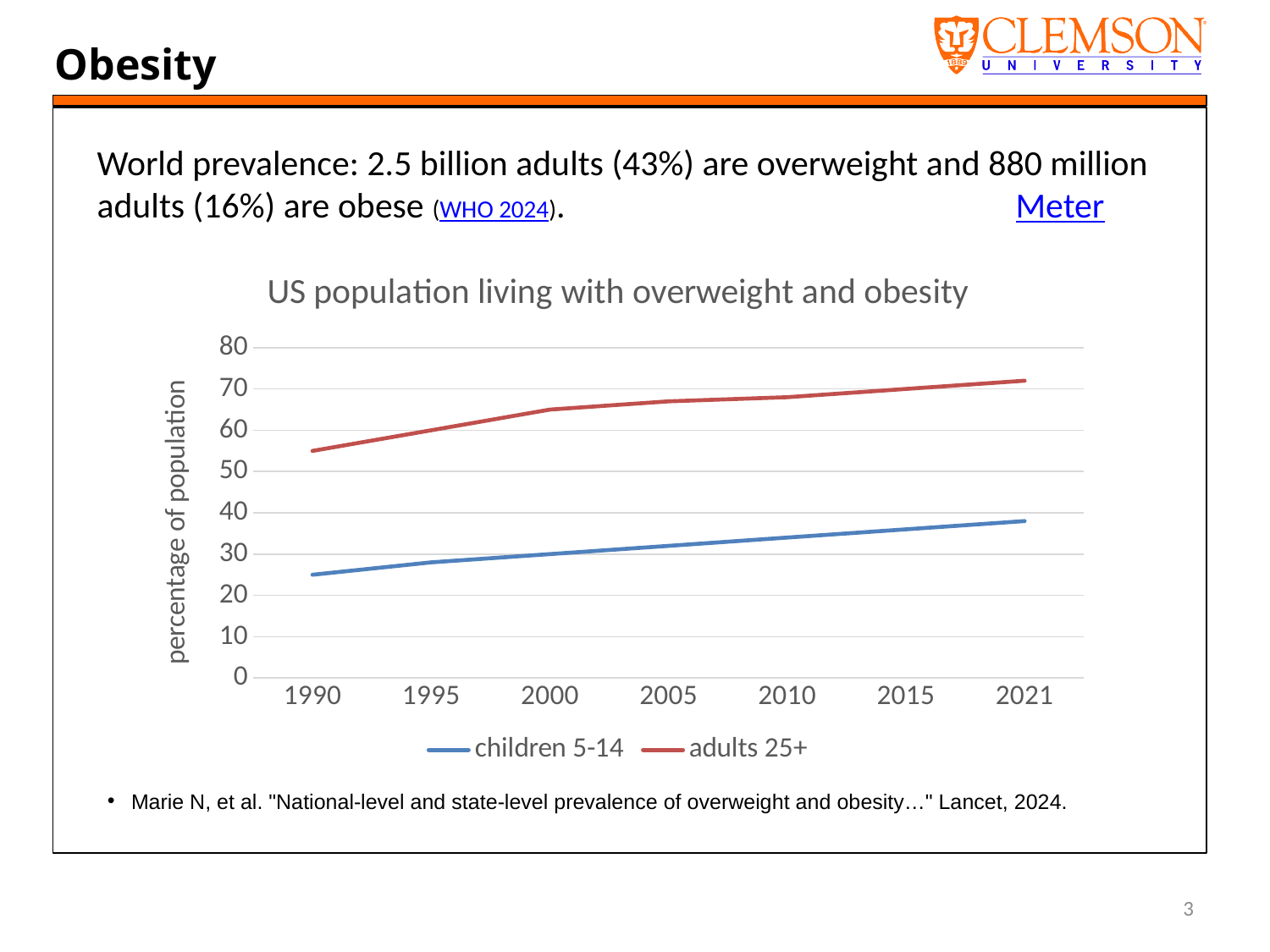
Is the value for children 5-14 in 2021 greater or less than 30? greater What is the title of the chart? US population living with overweight and obesity Is the value for children 5-14 in 1990 greater or less than 30? less How many years are plotted along the x axis? 7 Does the children 5-14 line rise or fall from 1990 to 2021? rise Which series has the higher value in 2010, children 5-14 or adults 25+? adults 25+ Does the adults 25+ line rise or fall from 1990 to 2021? rise What kind of chart is shown on the slide? line chart Is the value for adults 25+ in 1990 greater or less than 50? greater How many series does the legend list? 2 What is the label on the vertical axis? percentage of population